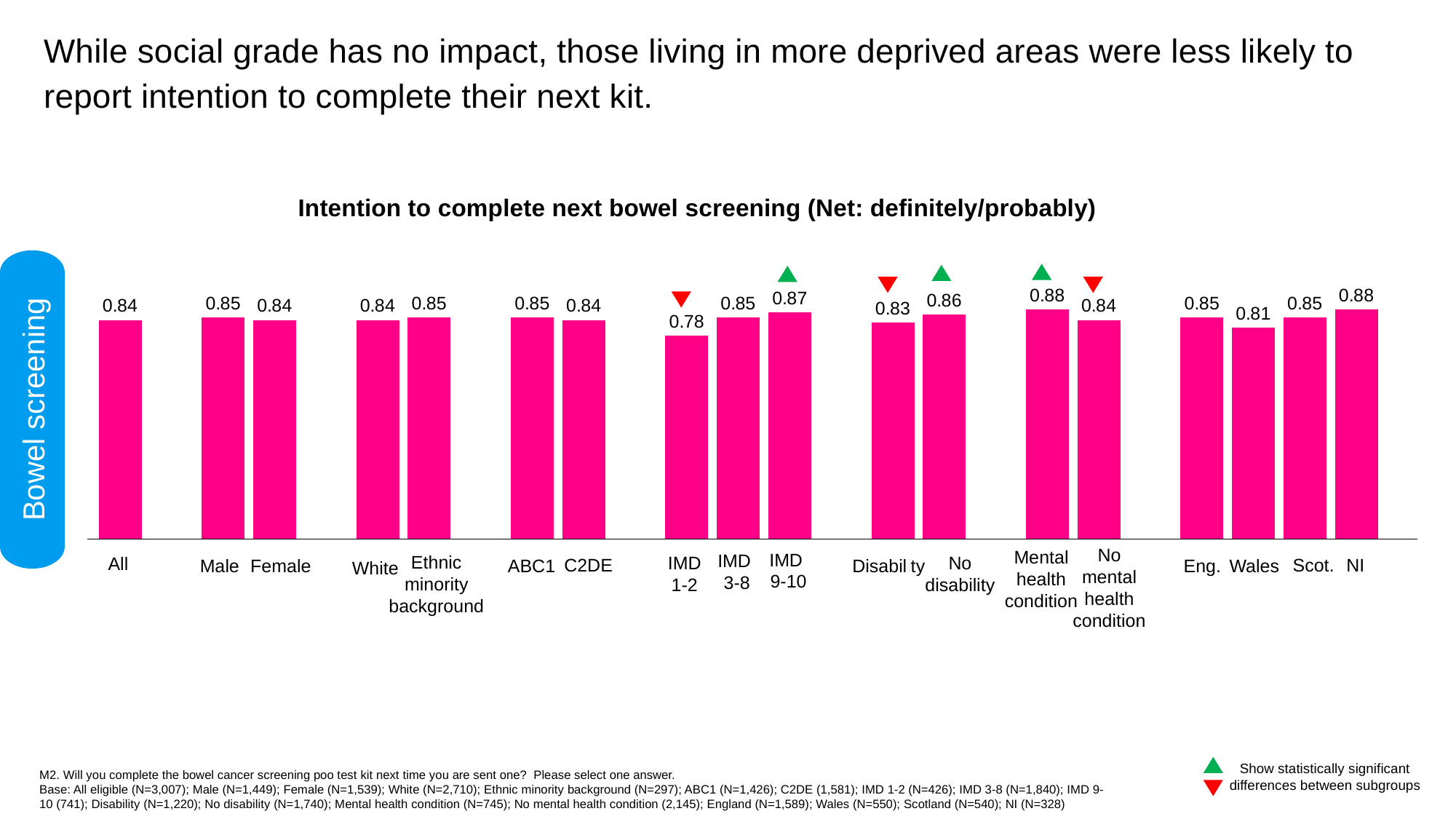
Which is larger, the value for IMD 1-2 or the value for IMD 3-8? IMD 3-8 What is the value for IMD 1-2? 0.78 What kind of chart is shown on the slide? Bar chart Which category has the lowest value? IMD 1-2 What is the difference between the values for IMD 9-10 and IMD 1-2? 0.09 Which is larger, the value for Disability or the value for No disability? No disability What is the value for Mental health condition? 0.88 How many bars are plotted in the chart? 18 What is the value for Wales? 0.81 What is the title of the chart? Intention to complete next bowel screening (Net: definitely/probably) What is the value for No disability? 0.86 What is the difference between the values for NI and Wales? 0.07